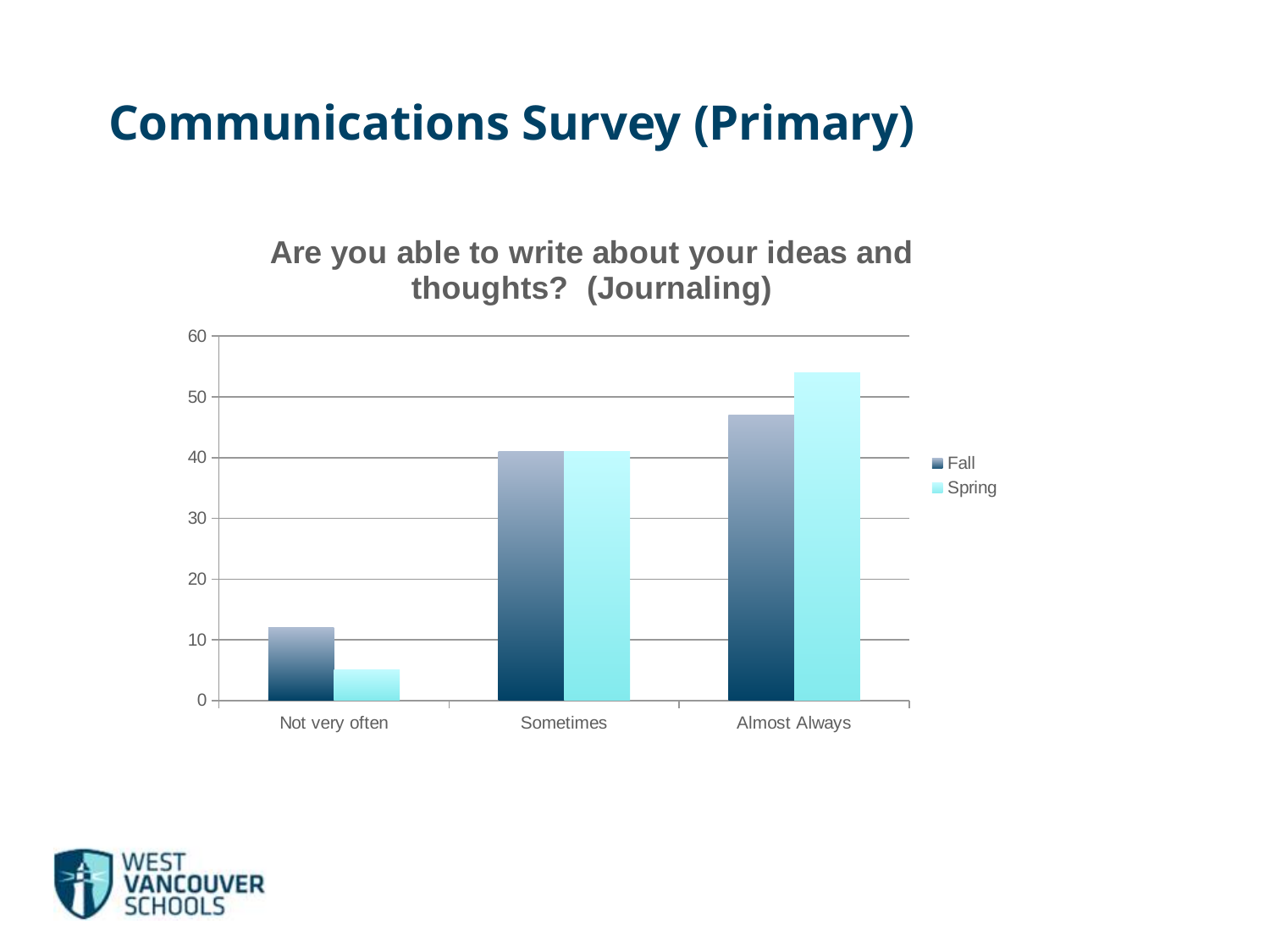
Which category has the lowest Fall value? Not very often Is the Fall value for Almost Always greater or less than 50? less Is the Spring value for Almost Always greater or less than 50? greater Is the Spring value for Not very often greater or less than 10? less How many categories are shown on the x axis? 3 How many series does the legend list? 2 What kind of chart is shown on the slide? bar chart Which category has the lowest Spring value? Not very often For Almost Always, which is larger, the Fall value or the Spring value? Spring Do the Spring values rise or fall from Not very often to Almost Always? rise Which category has the highest Spring value? Almost Always For Not very often, which is larger, the Fall value or the Spring value? Fall